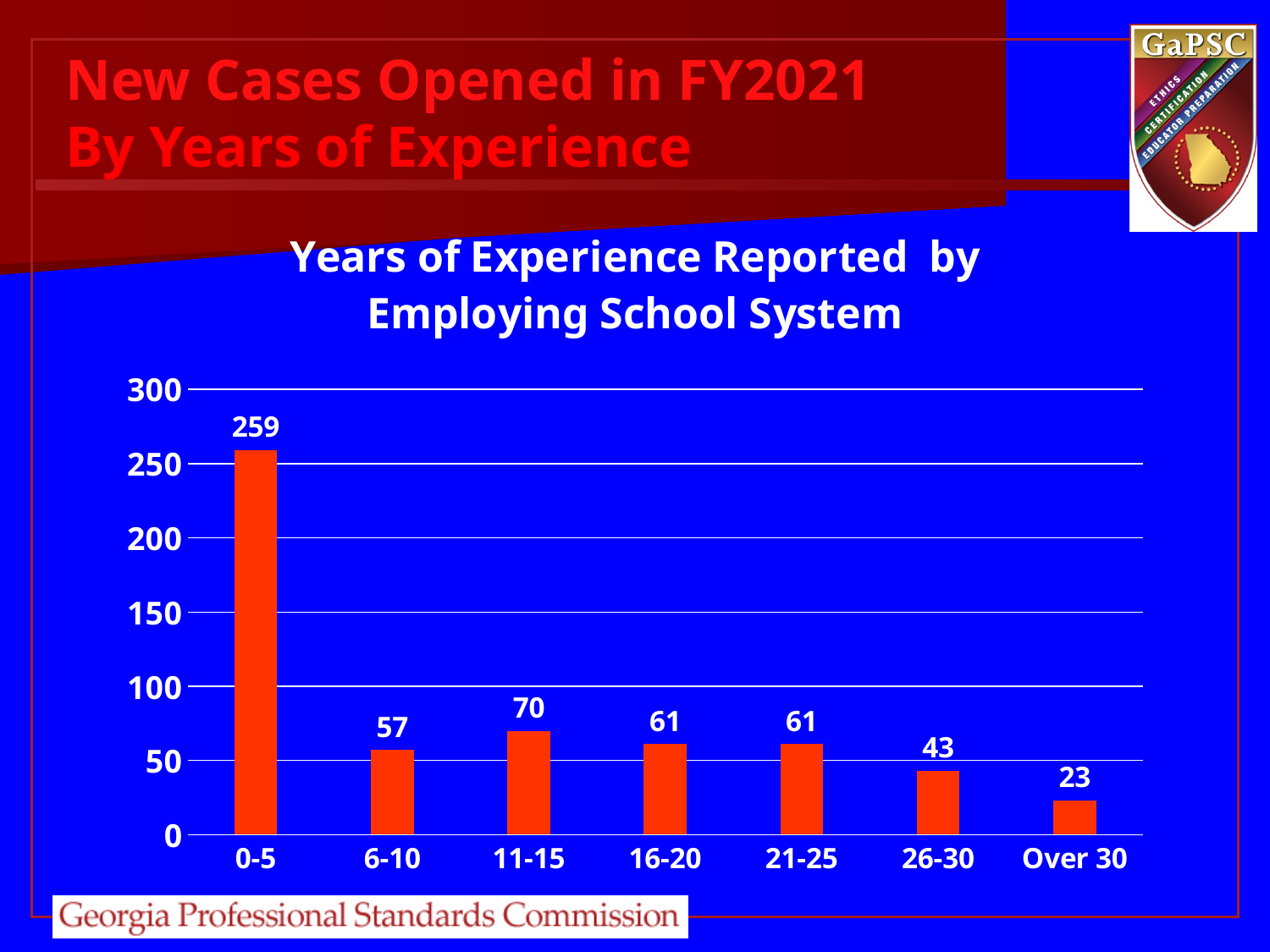
Which years-of-experience category has the highest value? 0-5 What is the value for the 26-30 years of experience category? 43 Which years-of-experience category has the lowest value? Over 30 What is the difference between the values for 0-5 and 6-10? 202 What kind of chart is shown on the slide? bar chart How many years-of-experience categories are shown on the x axis? 7 What is the difference between the values for 11-15 and 26-30? 27 What is the value for the Over 30 category? 23 Is the value for 0-5 greater or less than 250? greater What is the value for the 0-5 years of experience category? 259 Which is larger, the value for 11-15 or the value for 6-10? 11-15 What is the title of the chart? Years of Experience Reported by Employing School System